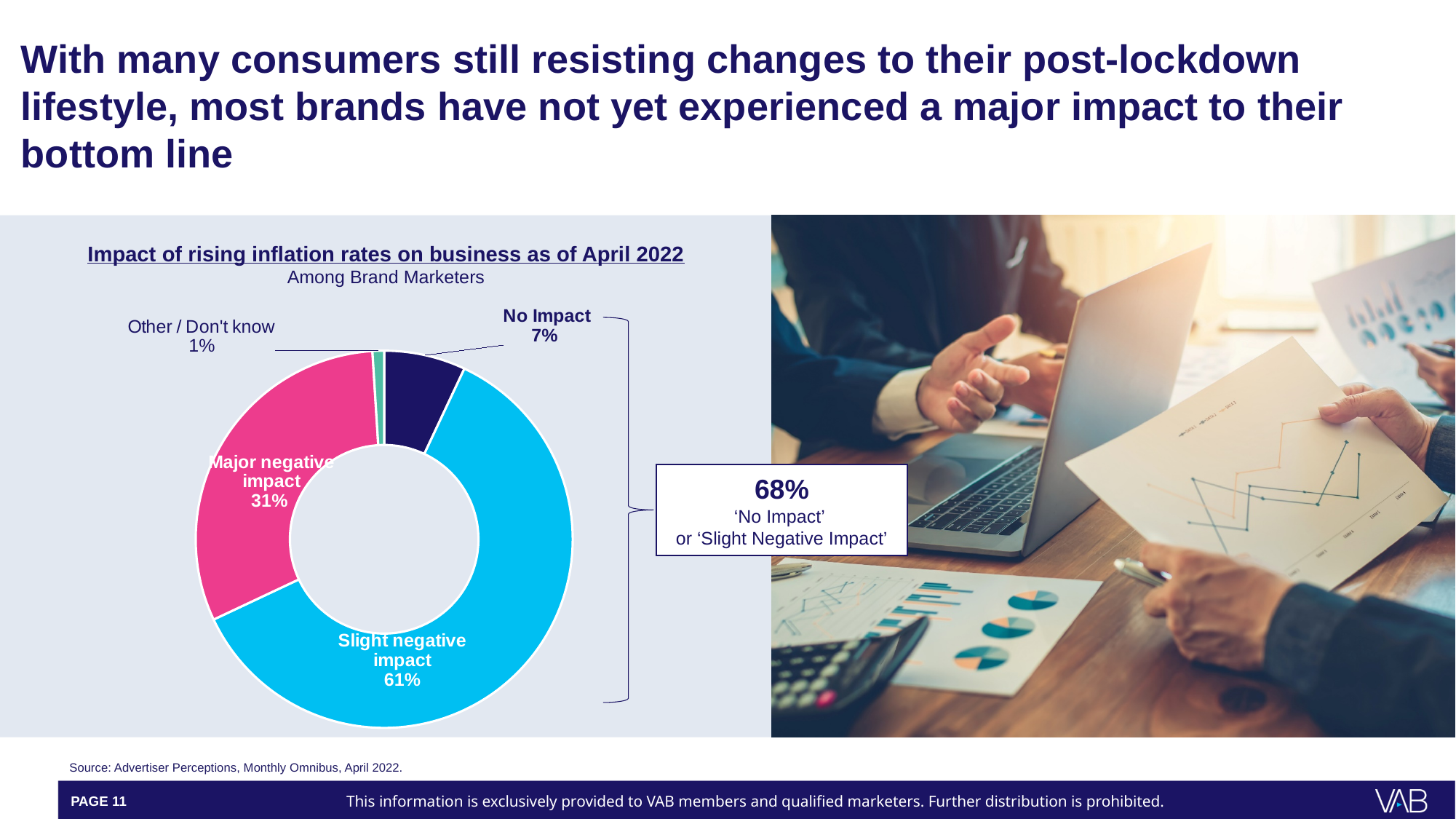
Which is larger: the share for 'No Impact' or the share for 'Major negative impact'? Major negative impact Which category has the largest share of the pie? Slight negative impact What is the combined share of 'No Impact' and 'Slight negative impact' according to the callout? 68% Which category has the smallest share of the pie? Other / Don't know What percentage of brand marketers reported a slight negative impact from rising inflation rates? 61% What kind of chart is shown on the slide? Pie chart (donut) How many categories are shown in the pie chart? 4 What percentage of brand marketers reported a major negative impact? 31% What is the difference in percentage points between 'Slight negative impact' and 'Major negative impact'? 30 percentage points What percentage of brand marketers reported no impact? 7% What share of the pie is labelled 'Other / Don't know'? 1% What is the title of the chart? Impact of rising inflation rates on business as of April 2022